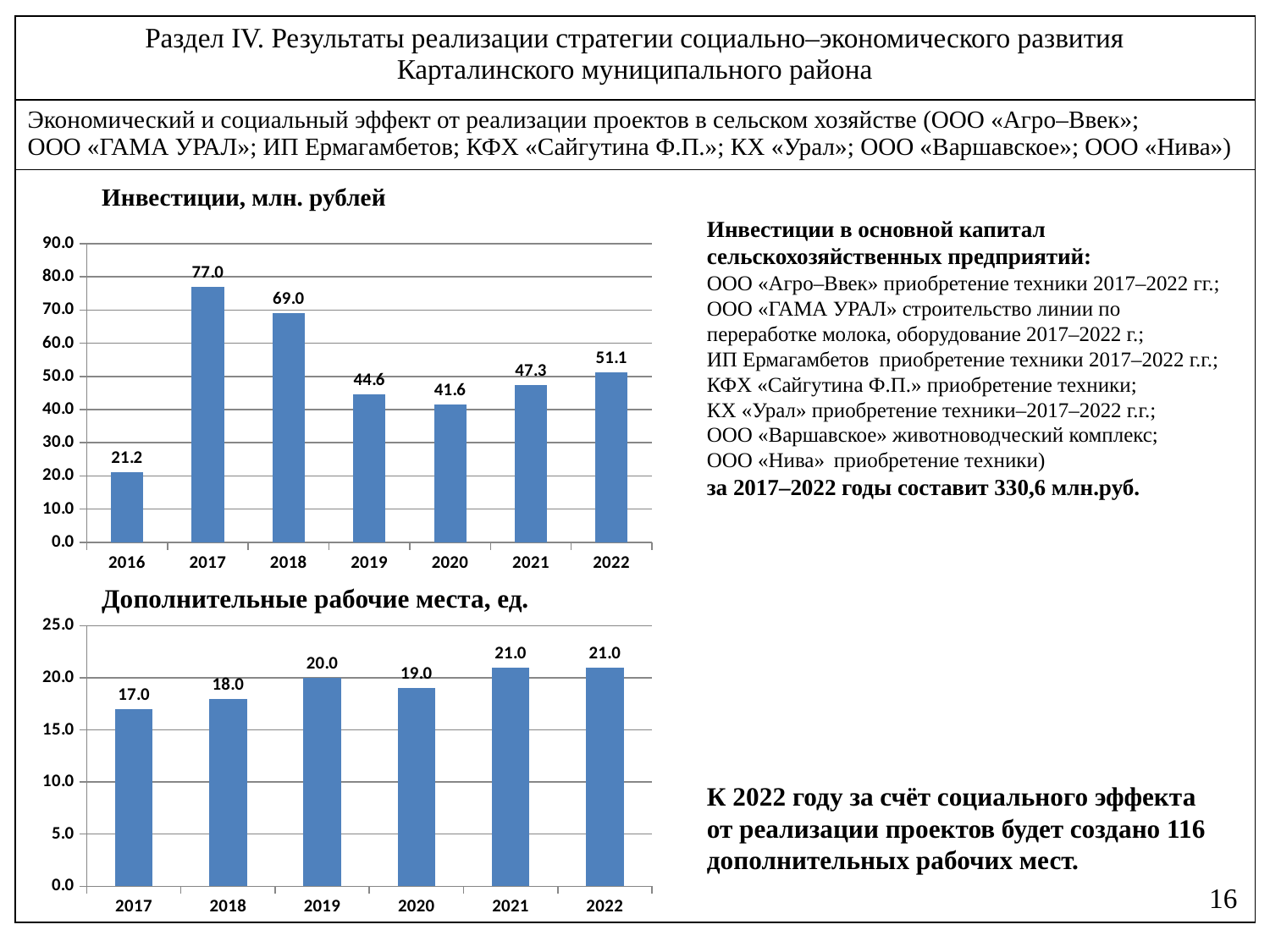
What type of chart is the chart 'Дополнительные рабочие места, ед.'? Bar chart In the chart 'Инвестиции, млн. рублей', which year has the lowest value? 2016 In the chart 'Дополнительные рабочие места, ед.', what is the difference between the values for 2022 and 2017? 4.0 In the chart 'Инвестиции, млн. рублей', what is the difference between the values for 2018 and 2019? 24.4 In the chart 'Инвестиции, млн. рублей', which year has the highest value? 2017 In the chart 'Дополнительные рабочие места, ед.', how many years are shown on the x axis? 6 In the chart 'Инвестиции, млн. рублей', what is the value for 2017? 77.0 In the chart 'Дополнительные рабочие места, ед.', which year has the lowest value? 2017 In the chart 'Инвестиции, млн. рублей', is the value for 2021 greater or less than 50.0? less In the chart 'Инвестиции, млн. рублей', which is larger, the value for 2020 or the value for 2022? 2022 In the chart 'Дополнительные рабочие места, ед.', what is the value for 2019? 20.0 In the chart 'Инвестиции, млн. рублей', how many years are shown on the x axis? 7